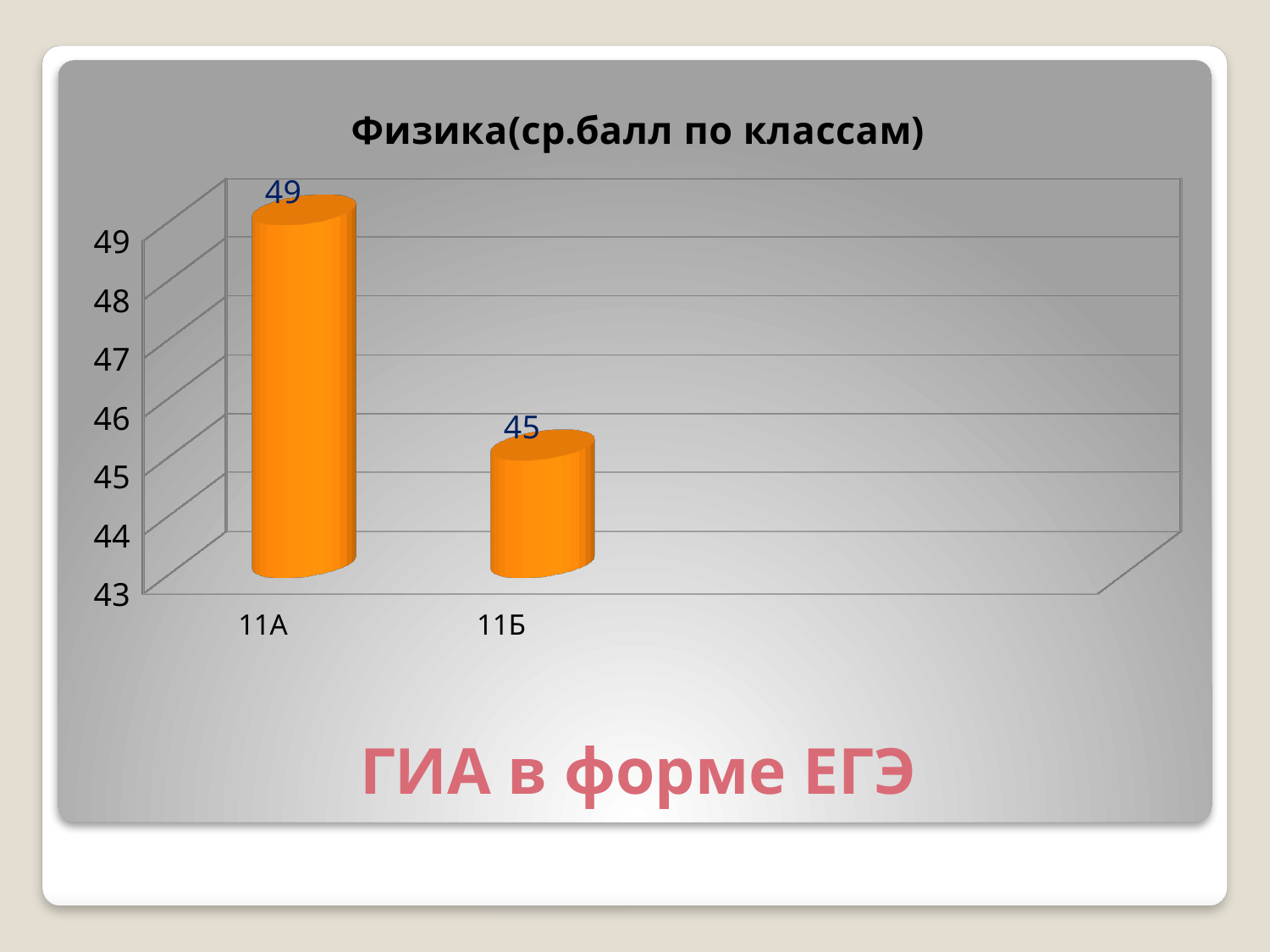
What is the difference between the average physics scores of 11А and 11Б? 4 What is the average physics score for class 11Б? 45 Which class has the lowest average physics score? 11Б What is the title of the chart? Физика(ср.балл по классам) How many classes are shown in the chart? 2 Is the value for 11Б greater or less than 47? less What colour are the bars in the chart? orange What kind of chart is shown on the slide? bar chart Do the values rise or fall from 11А to 11Б? fall Which class has a higher average physics score, 11А or 11Б? 11А What is the average physics score for class 11А? 49 Which class has the highest average physics score? 11А